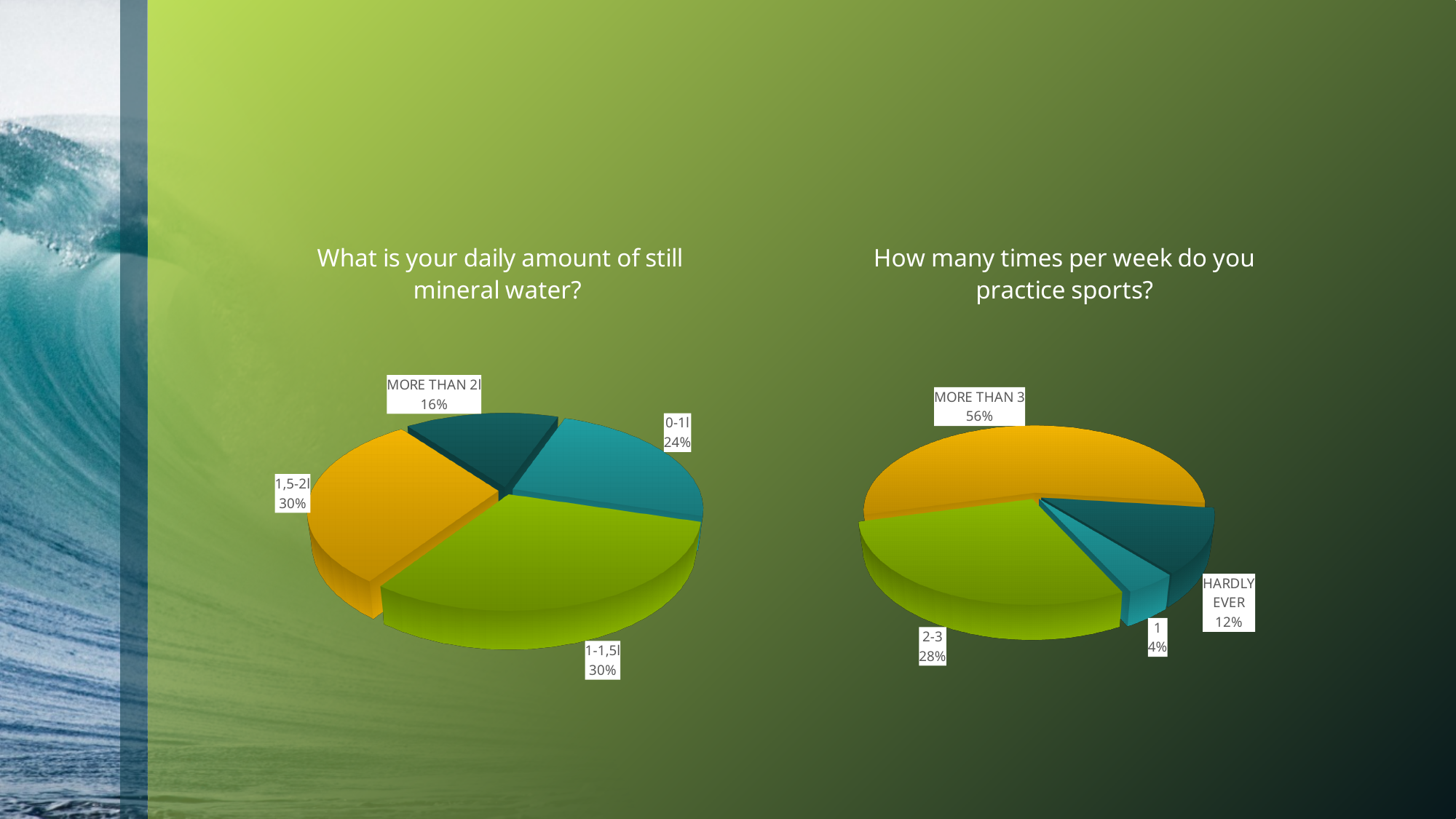
In the chart titled "How many times per week do you practice sports?", what share of respondents practice sports more than 3 times per week? 56% In the chart titled "What is your daily amount of still mineral water?", what share of respondents drink 0-1l? 24% In the chart titled "How many times per week do you practice sports?", what share of respondents answered "1"? 4% In the chart titled "How many times per week do you practice sports?", what colour is the MORE THAN 3 slice? Orange In the chart titled "What is your daily amount of still mineral water?", how many slices does the pie have? 4 In the chart titled "How many times per week do you practice sports?", which is larger: the share for 2-3 or the share for HARDLY EVER? 2-3 What kind of chart is used on the left side of the slide? Pie chart In the chart titled "What is your daily amount of still mineral water?", which category has the smallest share? MORE THAN 2l In the chart titled "What is your daily amount of still mineral water?", what share of respondents drink more than 2l? 16% In the chart titled "How many times per week do you practice sports?", which category has the largest share? MORE THAN 3 In the chart titled "What is your daily amount of still mineral water?", what is the difference in percentage points between the 1,5-2l slice and the 0-1l slice? 6 In the chart titled "How many times per week do you practice sports?", what is the difference in percentage points between the MORE THAN 3 slice and the 2-3 slice? 28